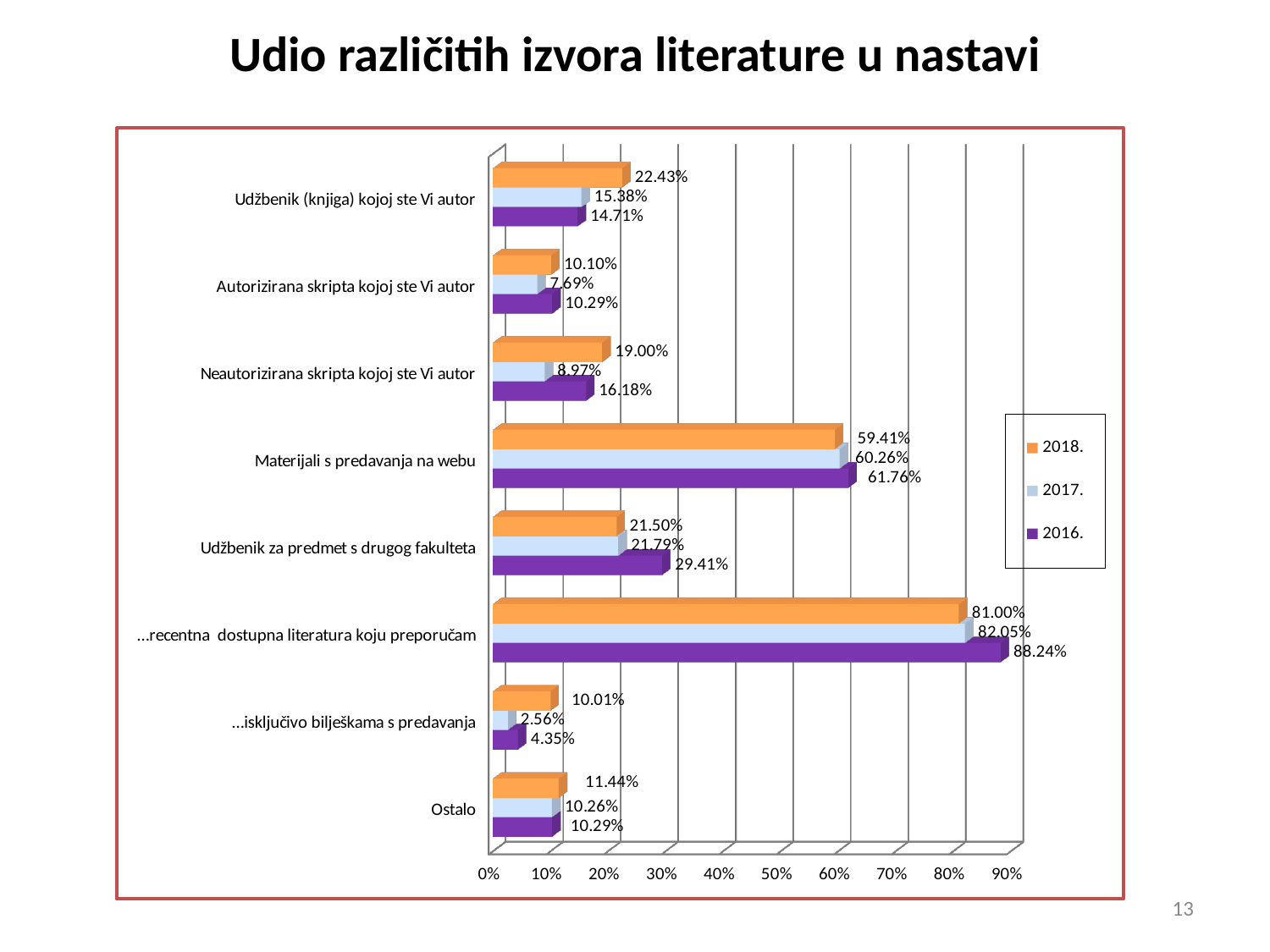
For 'Neautorizirana skripta kojoj ste Vi autor', which is larger: the 2018. value or the 2017. value? 2018. What is the value for 2018. for 'Udžbenik (knjiga) kojoj ste Vi autor'? 22.43% What is the difference between the 2016. and 2018. values for 'Udžbenik za predmet s drugog fakulteta'? 7.91% Which category has the lowest value for 2017.? ...isključivo bilješkama s predavanja How many series does the legend list? 3 Which category has the highest value for 2018.? ...recentna dostupna literatura koju preporučam What is the value for 2016. for '...recentna dostupna literatura koju preporučam'? 88.24% What is the title of the chart? Udio različitih izvora literature u nastavi What kind of chart is shown on the slide? bar chart What is the value for 2017. for 'Materijali s predavanja na webu'? 60.26% How many categories are shown on the chart? 8 Is the 2016. value for 'Materijali s predavanja na webu' greater or less than 50%? greater